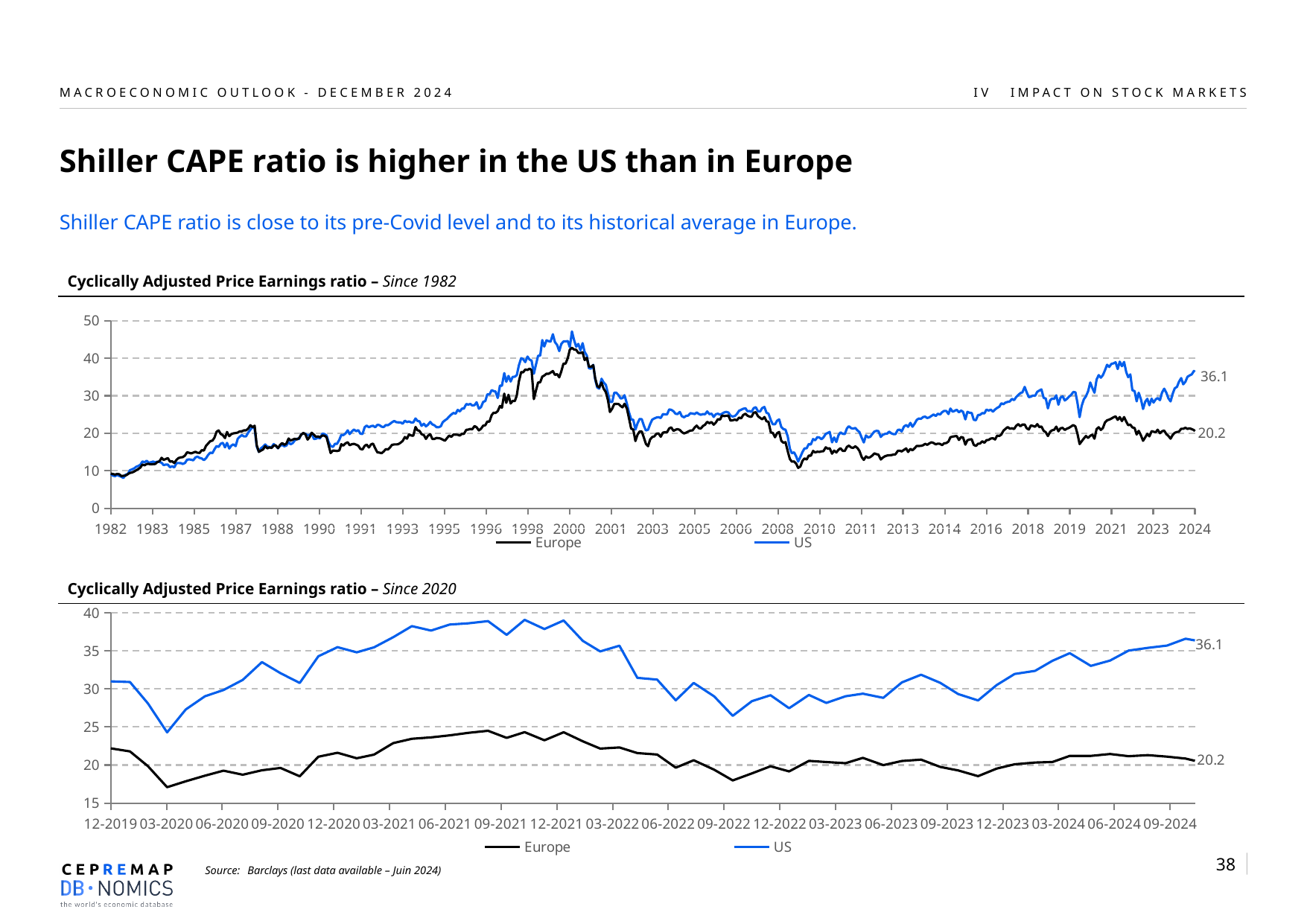
On the 'Since 1982' chart, is the Europe value at its 2009 low greater or less than 20? less On the 'Since 2020' chart, is the US value at 09-2022 greater or less than 30? less What kind of chart is the 'Since 2020' chart? Line chart How many series does the legend of the 'Since 1982' chart list? 2 On the 'Since 2020' chart, what is the latest value labelled for the US line? 36.1 On the 'Since 2020' chart, does the US series generally rise or fall from 12-2022 to 09-2024? rise On the 'Since 1982' chart, what is the latest value shown for the US series? 36.1 On the 'Since 1982' chart, is the peak value of the US series around 2000 greater or less than 40? greater On the 'Since 1982' chart, what is the latest value shown for the Europe series? 20.2 What is the title of the top chart on the slide? Cyclically Adjusted Price Earnings ratio – Since 1982 On the 'Since 2020' chart, which series has the higher latest value, Europe or US? US On the 'Since 2020' chart, what is the difference between the latest US value and the latest Europe value? 15.9